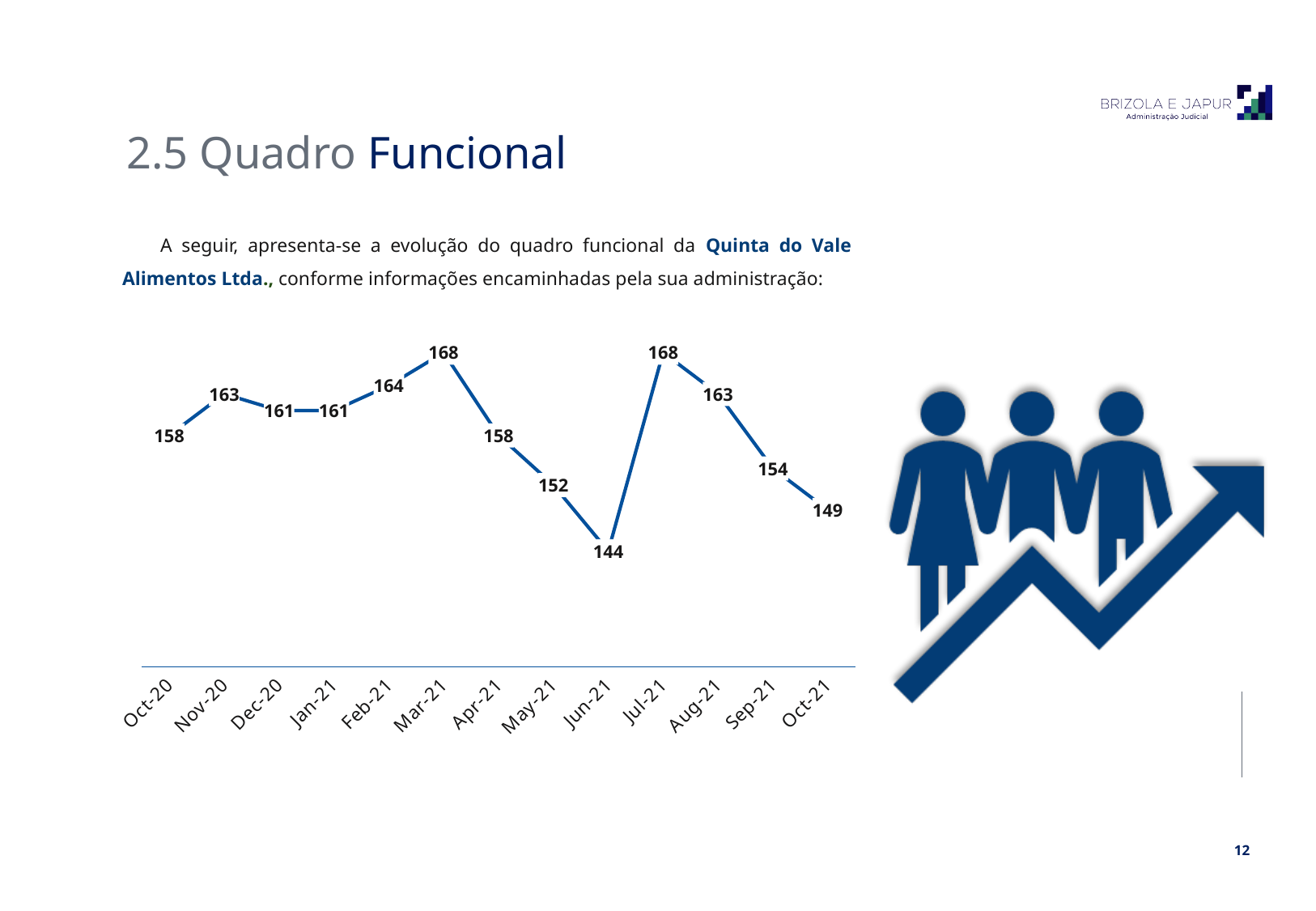
What is the value for Feb-21? 164 What kind of chart is shown on the slide? Line chart What is the value for Oct-20? 158 How many months are plotted on the chart? 13 What is the difference between the values for Mar-21 and Oct-21? 19 Do the values rise or fall from Jul-21 to Oct-21? Fall Which is larger, the value for Nov-20 or the value for Sep-21? Nov-20 What is the value for Oct-21? 149 What is the difference between the values for Jul-21 and Jun-21? 24 What is the highest value shown on the chart? 168 What is the value for Jun-21? 144 Which month has the lowest value? Jun-21